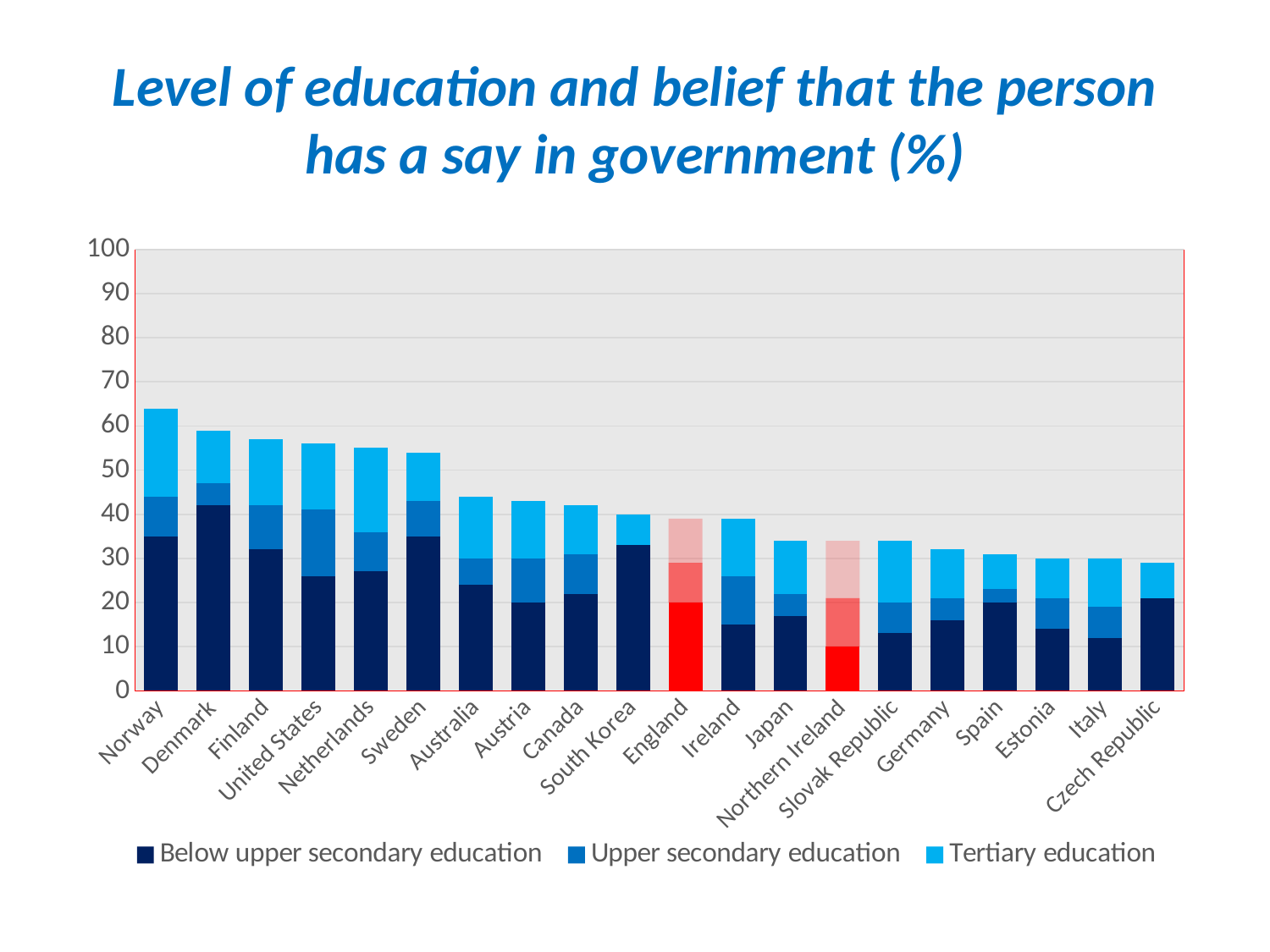
Is the total bar for Australia greater or less than 50? less Do the total bar heights generally rise or fall from left to right across the countries? fall What kind of chart is shown on the slide? Stacked bar chart How many series does the legend list? 3 How many countries are shown on the x axis of the chart? 20 Is the 'Below upper secondary education' value for Ireland greater or less than 20? less Is the total bar for Norway greater or less than 60? greater Which two countries' bars are highlighted in red in the chart? England and Northern Ireland Which has the larger 'Below upper secondary education' value, Norway or Denmark? Denmark Which country has the highest total bar in the chart? Norway